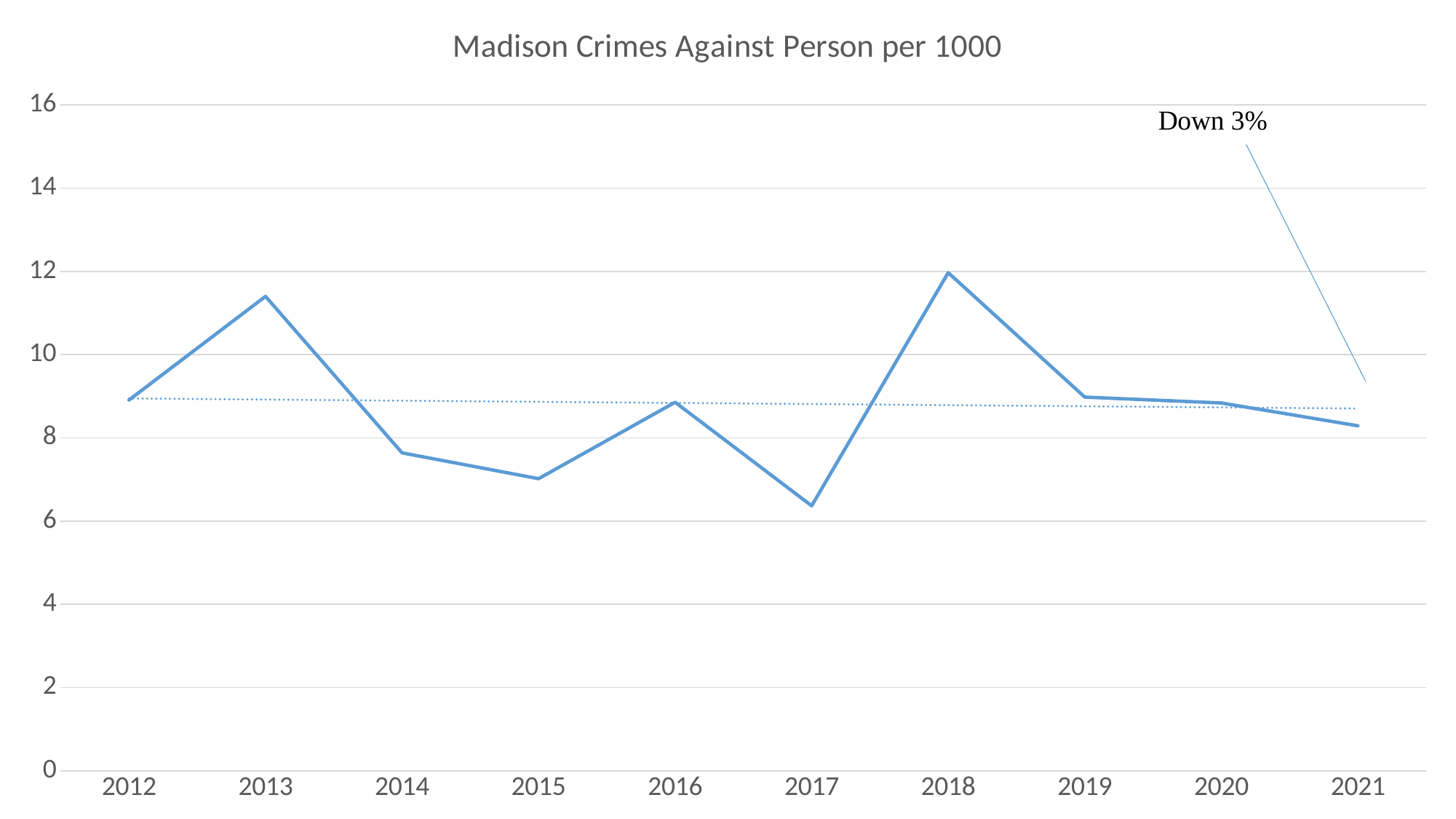
Is the value for 2017 greater or less than 8? less What is the title of the chart? Madison Crimes Against Person per 1000 How many years are plotted along the x axis? 10 Is the value for 2013 greater or less than 10? greater Which year has the lowest crimes against person per 1000? 2017 Which year has the highest crimes against person per 1000? 2018 What type of chart is shown on the slide? line chart Do the values rise or fall from 2018 to 2021? fall Is the value for 2014 greater or less than 8? less What does the annotation near the 2021 data point say? Down 3% Which year has a higher value, 2016 or 2017? 2016 Which year has a higher value, 2013 or 2014? 2013